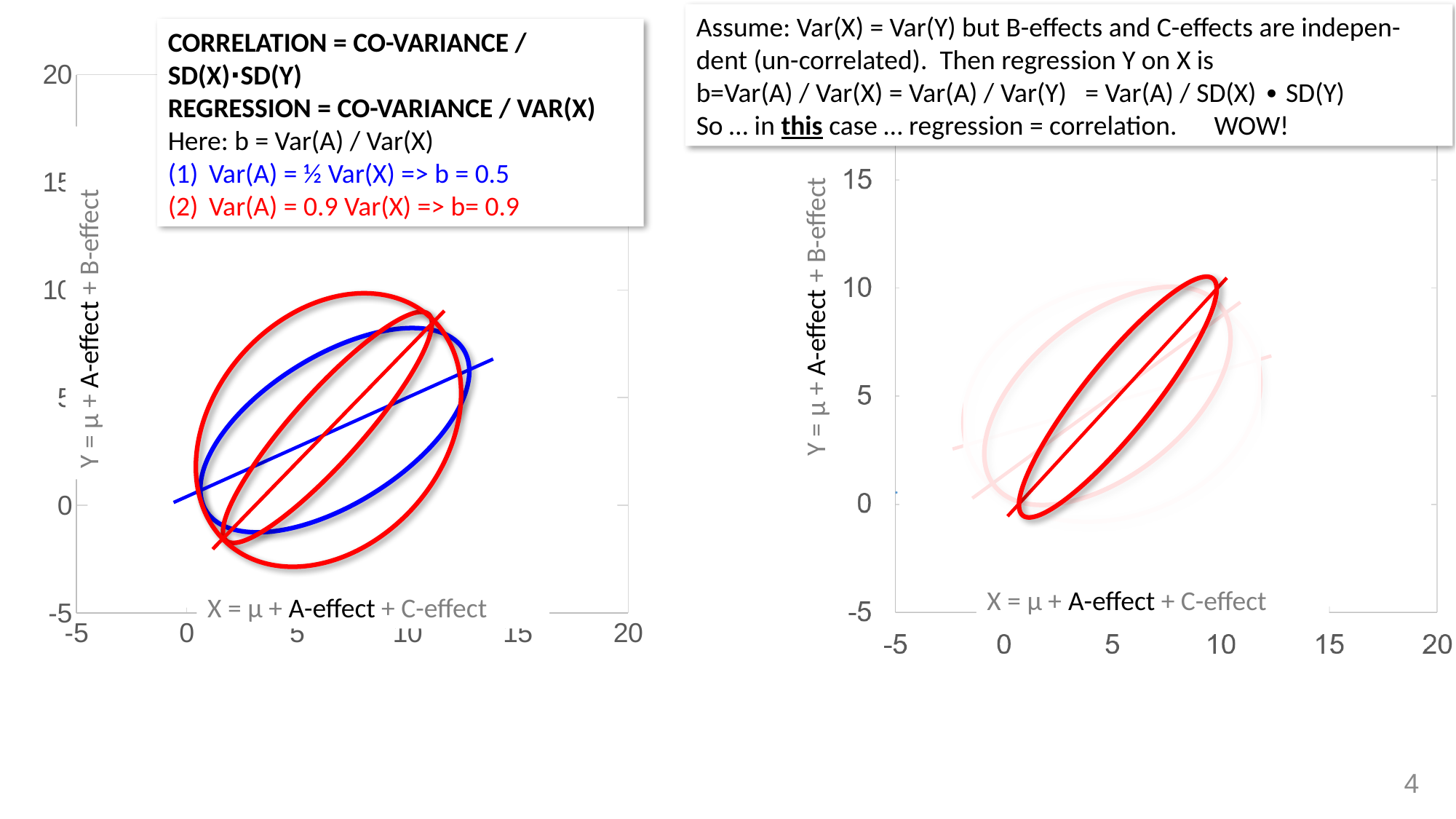
On the left chart, is the value of the red line at x = 10 greater or less than 5? greater On the left chart, do the regression lines rise or fall as x increases? rise On the left chart, what is the highest tick value shown on the x axis? 20 On the right chart, is the value of the red line at x = 10 greater or less than 5? greater On the right chart, does the bold red line rise or fall along the x axis? rise On the right chart, what is the label of the y axis? Y = μ + A-effect + B-effect On the left chart, which line is steeper, the blue line or the red line? the red line On the left chart, what is the label of the x axis? X = μ + A-effect + C-effect On the left chart, is the value of the blue line at x = 5 greater or less than 5? less On the right chart, what is the highest tick value shown on the y axis? 15